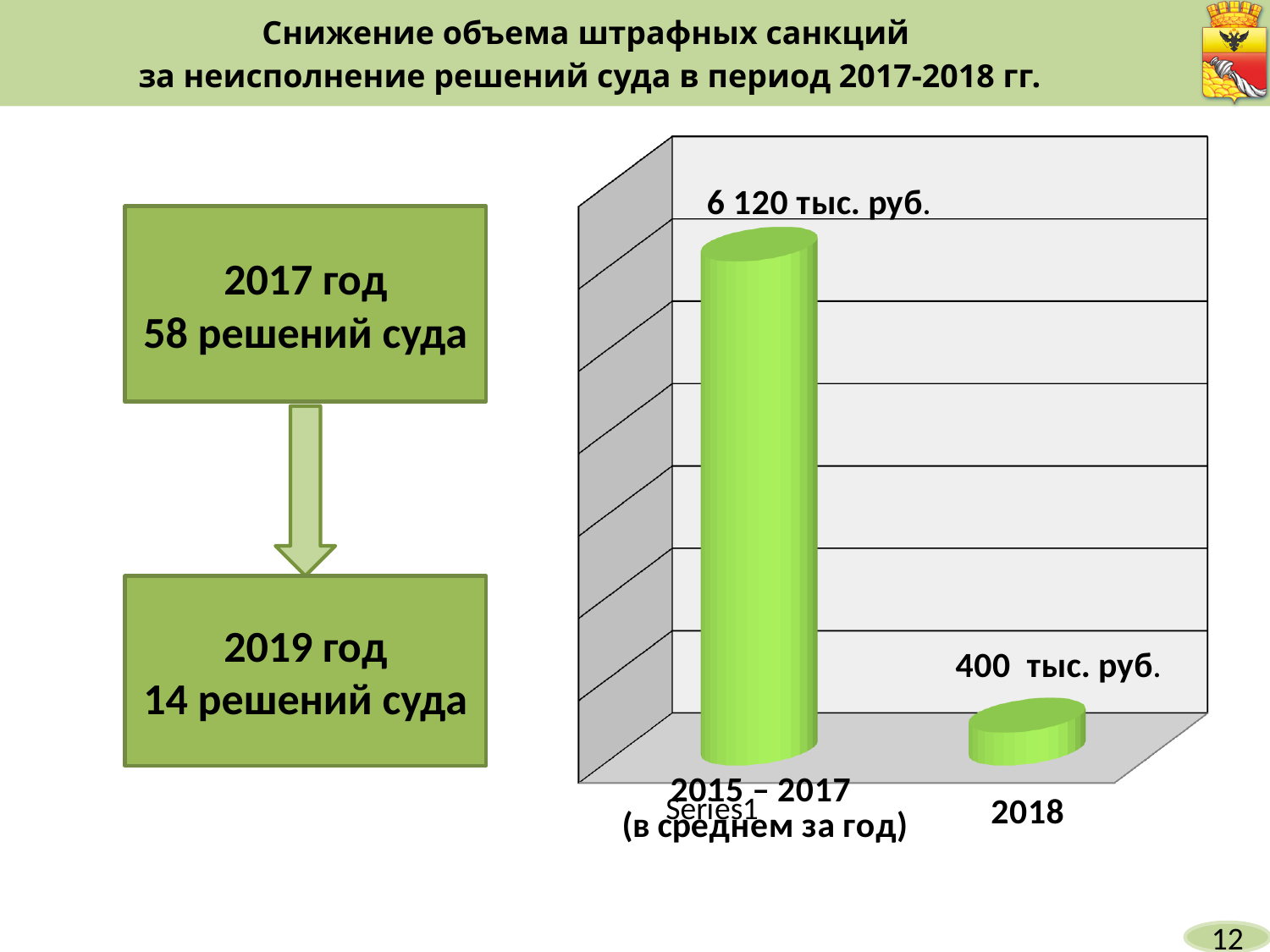
Which category has the lowest value? 2018 What kind of chart is shown on the slide? Bar chart What is the value shown for the 2015 – 2017 (в среднем за год) bar? 6 120 тыс. руб. What is the value shown for the 2018 bar? 400 тыс. руб. Which is larger: the value for 2015 – 2017 (в среднем за год) or the value for 2018? 2015 – 2017 (в среднем за год) What is the difference between the 2015 – 2017 average value and the 2018 value? 5 720 тыс. руб. What colour are the bars in the chart? Green What is the title of the slide containing the chart? Снижение объема штрафных санкций за неисполнение решений суда в период 2017-2018 гг. How many bars are plotted in the chart? 2 Which category has the highest value? 2015 – 2017 (в среднем за год) Do the values rise or fall from the 2015 – 2017 bar to the 2018 bar? Fall